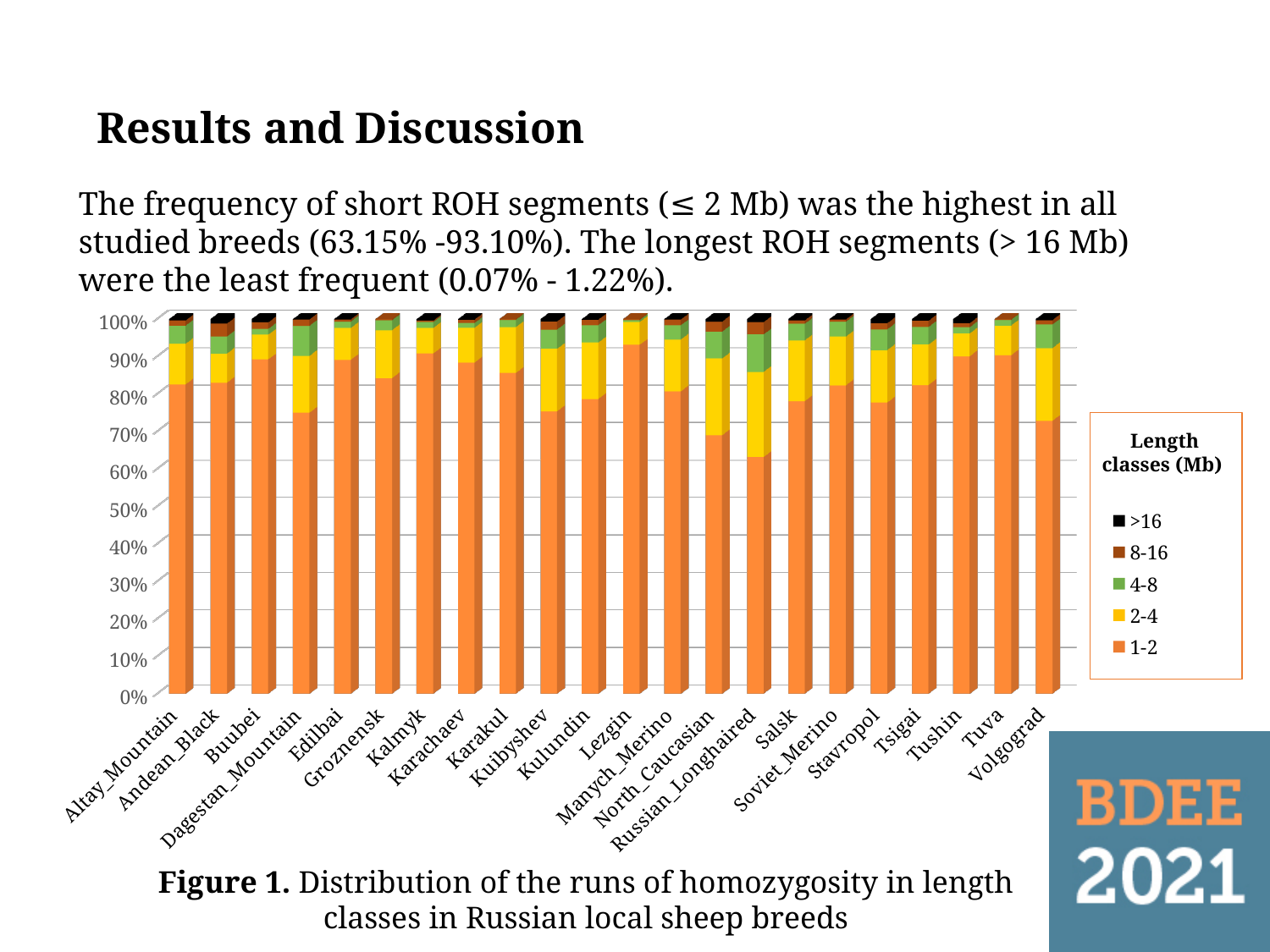
How many length classes does the chart legend list? 5 What kind of chart is shown in Figure 1? stacked bar chart Which breed has a larger 1-2 Mb share, Lezgin or Russian_Longhaired? Lezgin Which breed has the smallest share of 1-2 Mb ROH segments? Russian_Longhaired Is the 1-2 Mb share for Russian_Longhaired greater or less than 70%? less Which breed has a larger 2-4 Mb share, Russian_Longhaired or Lezgin? Russian_Longhaired Is the 1-2 Mb share for Lezgin greater or less than 90%? greater Which colour represents the 1-2 Mb length class in the chart? orange Which breed has the largest share of 1-2 Mb ROH segments? Lezgin What is the title of the chart legend? Length classes (Mb) How many sheep breeds are shown along the x axis of the chart? 22 Is the 1-2 Mb share for Dagestan_Mountain greater or less than 70%? greater